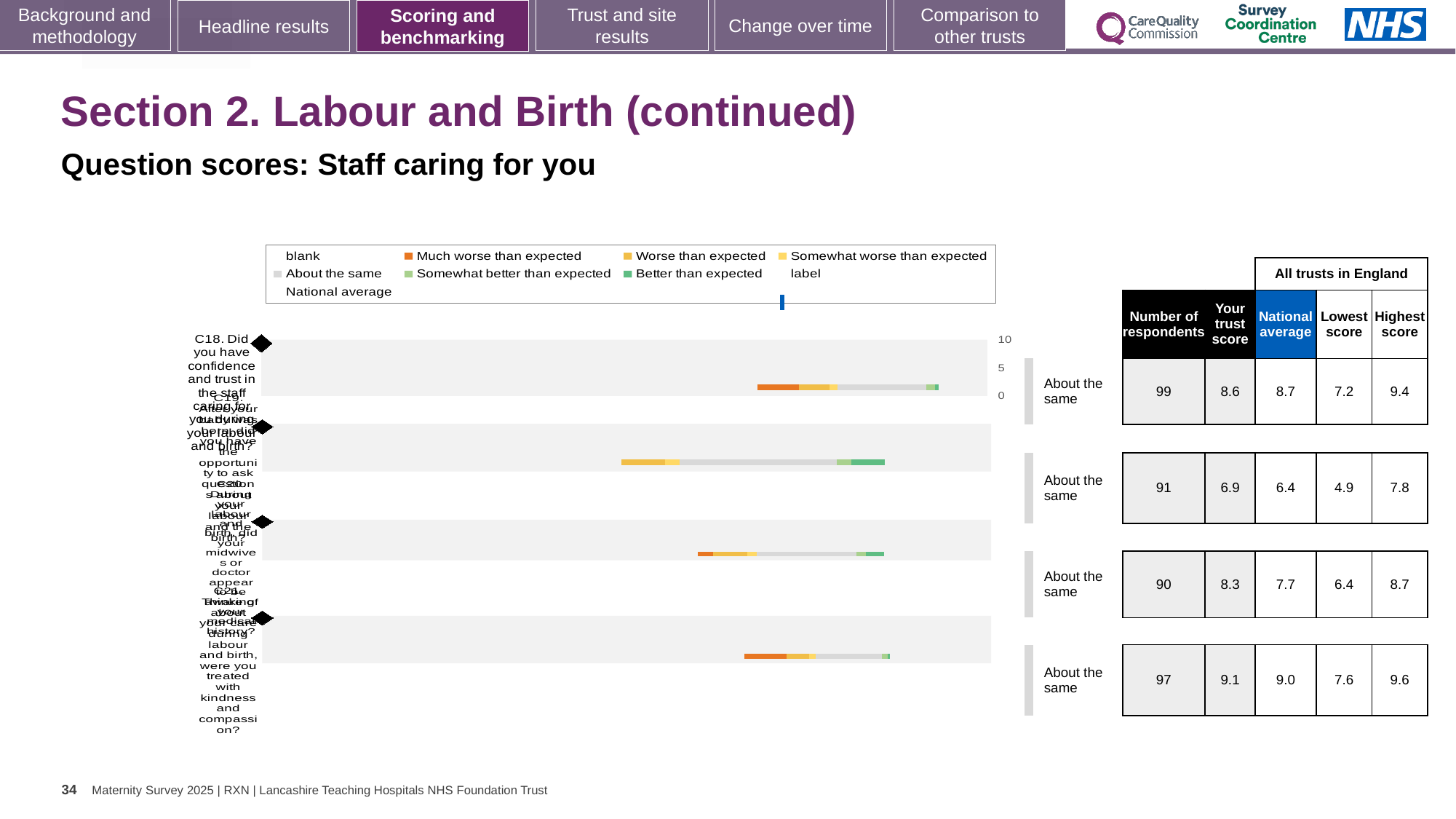
What is the trust score for the first row (C18)? 8.6 For the third row (C20), which is larger: the trust score or the national average? trust score (8.3) How many questions (bars) are plotted in the chart? 4 In the table, what is the number of respondents for the first row (C18)? 99 What benchmark category is shown next to each of the four bars? About the same Which row has the highest trust score? C21 (fourth row), 9.1 What is the highest score for the fourth row (C21)? 9.6 What is the number of respondents for the third row (C20)? 90 What kind of chart is shown on the slide? bar chart Which row has the lowest trust score? C19 (second row), 6.9 What is the national average for the first row (C18)? 8.7 For the second row (C19), what is the difference between the highest score and the lowest score? 2.9